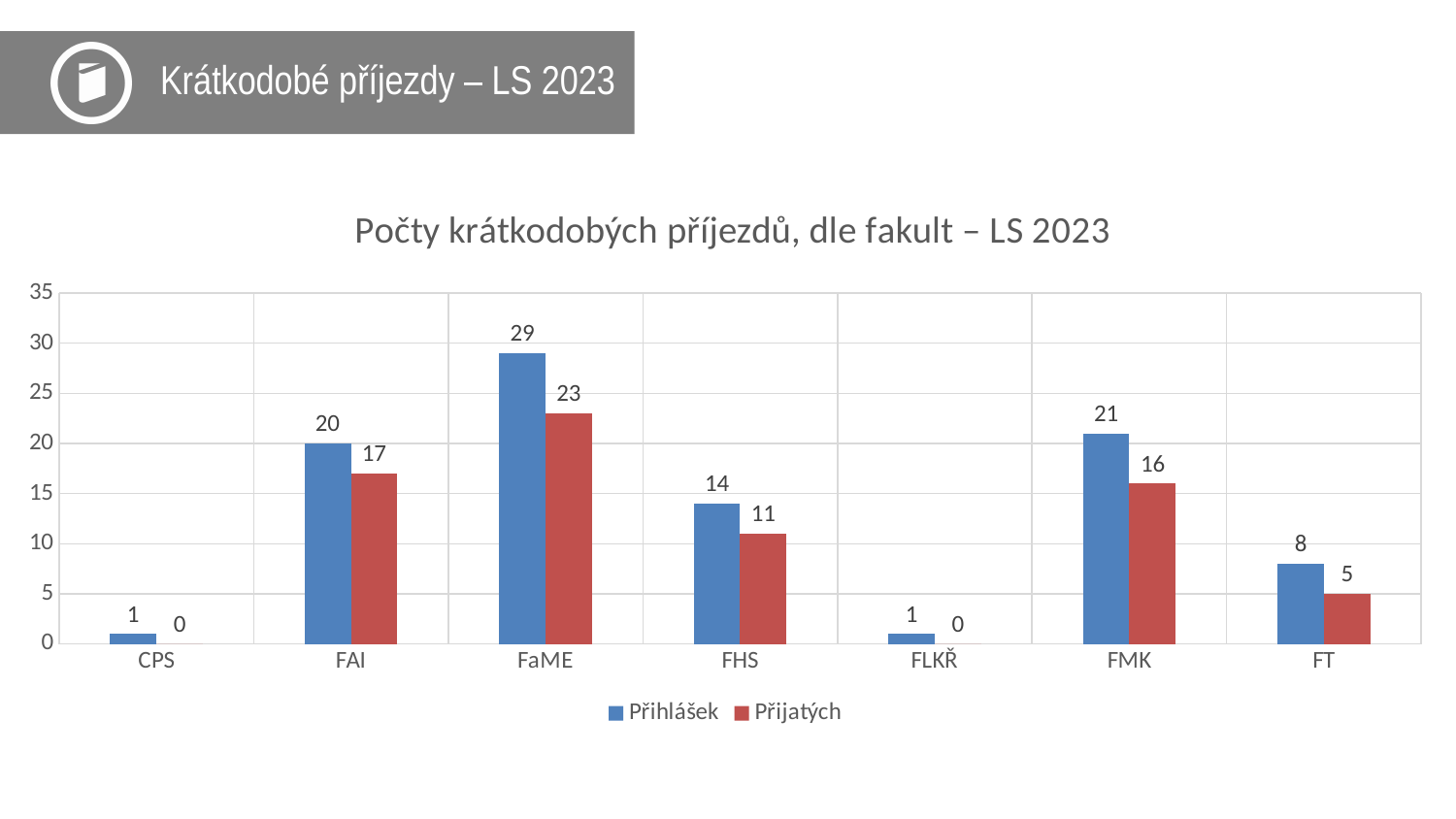
How many series does the legend list? 2 Which faculty has the highest Přihlášek value? FaME What is the difference between Přihlášek and Přijatých for FAI? 3 What is the value of Přijatých for FMK? 16 Which is larger, Přijatých for FAI or Přijatých for FMK? Přijatých for FAI What kind of chart is shown on the slide? Bar chart Which faculty has the lowest Přijatých value? CPS and FLKŘ (both 0) What is the value of Přihlášek for FaME? 29 How many faculties are shown on the x axis? 7 What is the value of Přijatých for FT? 5 What is the difference between the Přihlášek values for FaME and FHS? 15 What is the title of the chart? Počty krátkodobých příjezdů, dle fakult – LS 2023